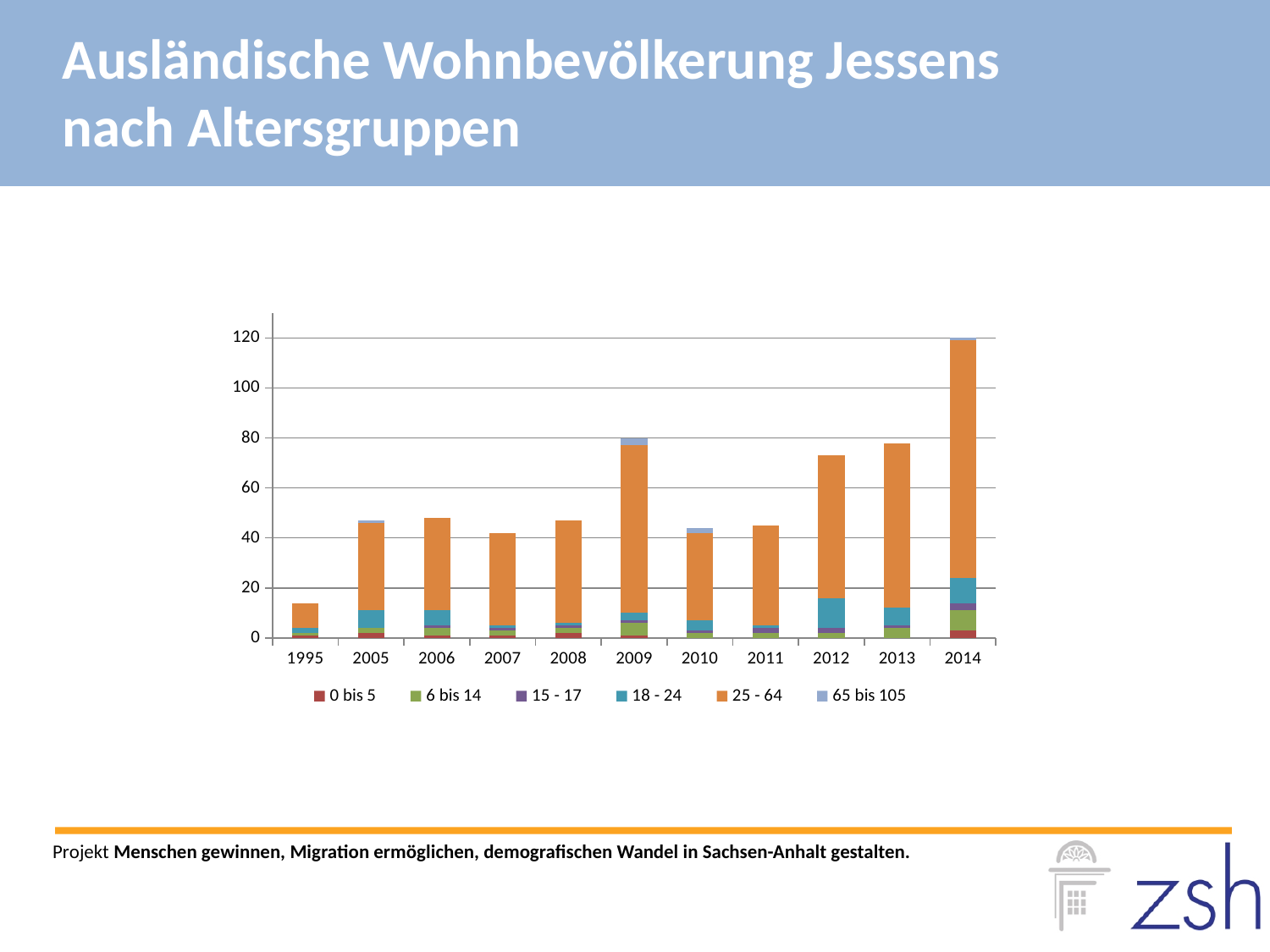
What is the first age group listed in the legend? 0 bis 5 Which year has the shortest stacked bar? 1995 Which age group makes up the largest part of each bar? 25 - 64 How many age groups does the legend list? 6 Is the total for 2010 greater or less than 60? less Is the total for 1995 greater or less than 20? less How many years are shown on the x axis of the chart? 11 Which year has the larger total, 2012 or 2010? 2012 Is the total for 2009 greater or less than 60? greater Which year has the tallest stacked bar? 2014 What kind of chart is shown on the slide? stacked bar chart